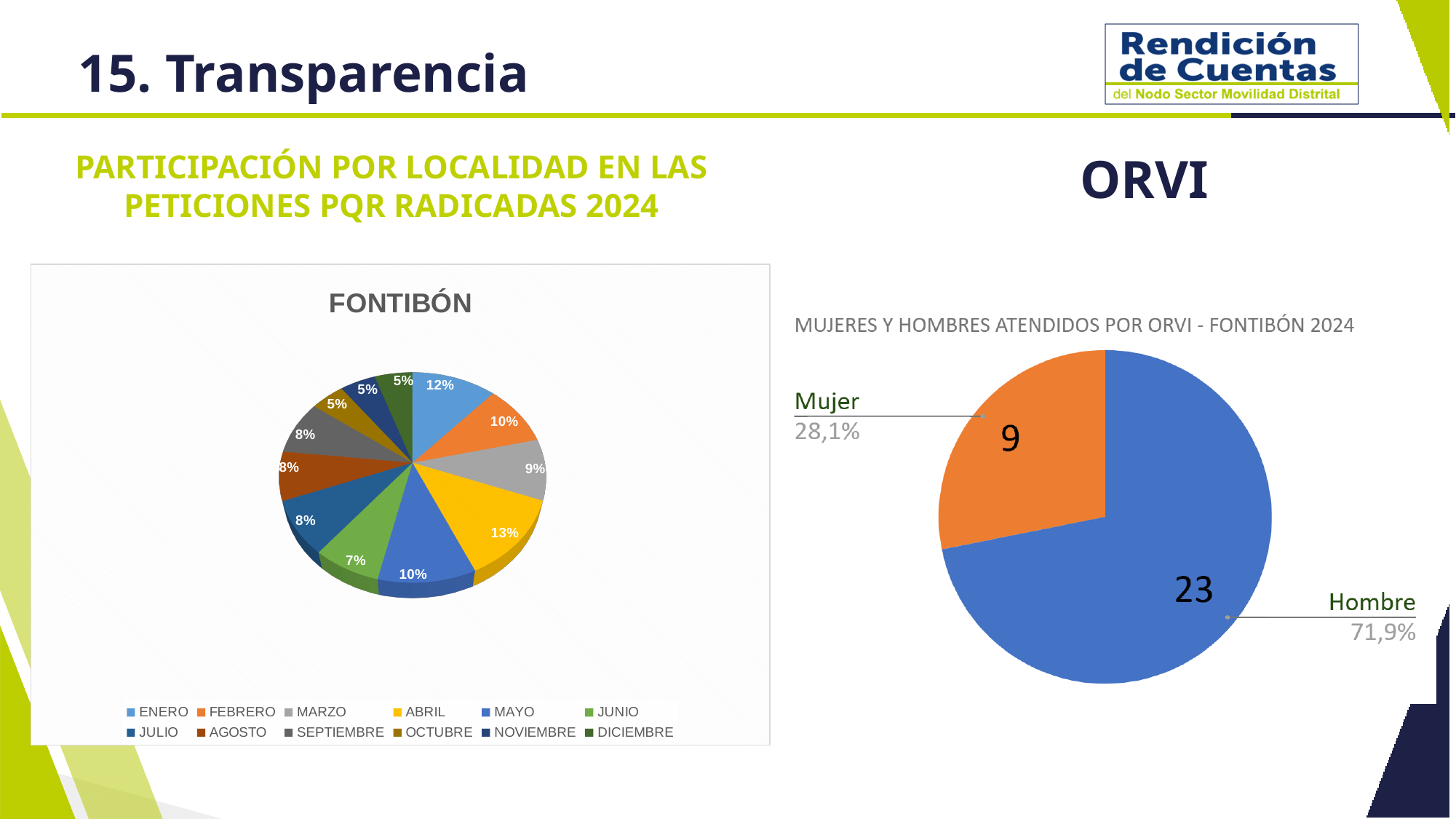
In the chart 'MUJERES Y HOMBRES ATENDIDOS POR ORVI - FONTIBÓN 2024', what share of the pie does Mujer represent? 28,1% In the FONTIBÓN pie chart, what is the difference between the ABRIL share and the MARZO share? 4% In the FONTIBÓN pie chart, what percentage is shown for ENERO? 12% In the FONTIBÓN pie chart, what percentage is shown for ABRIL? 13% In the chart 'MUJERES Y HOMBRES ATENDIDOS POR ORVI - FONTIBÓN 2024', how many Hombres were attended? 23 In the FONTIBÓN pie chart, which month has the largest share? ABRIL In the FONTIBÓN pie chart, which is larger, the share for FEBRERO or the share for JUNIO? FEBRERO In the chart 'MUJERES Y HOMBRES ATENDIDOS POR ORVI - FONTIBÓN 2024', what is the difference between the number of Hombres and Mujeres? 14 In the chart 'MUJERES Y HOMBRES ATENDIDOS POR ORVI - FONTIBÓN 2024', what is the total number of people attended? 32 In the chart 'MUJERES Y HOMBRES ATENDIDOS POR ORVI - FONTIBÓN 2024', what colour is the Hombre slice? Blue In the FONTIBÓN pie chart, how many months (categories) does the legend list? 12 What kind of chart is the FONTIBÓN chart on the left? Pie chart